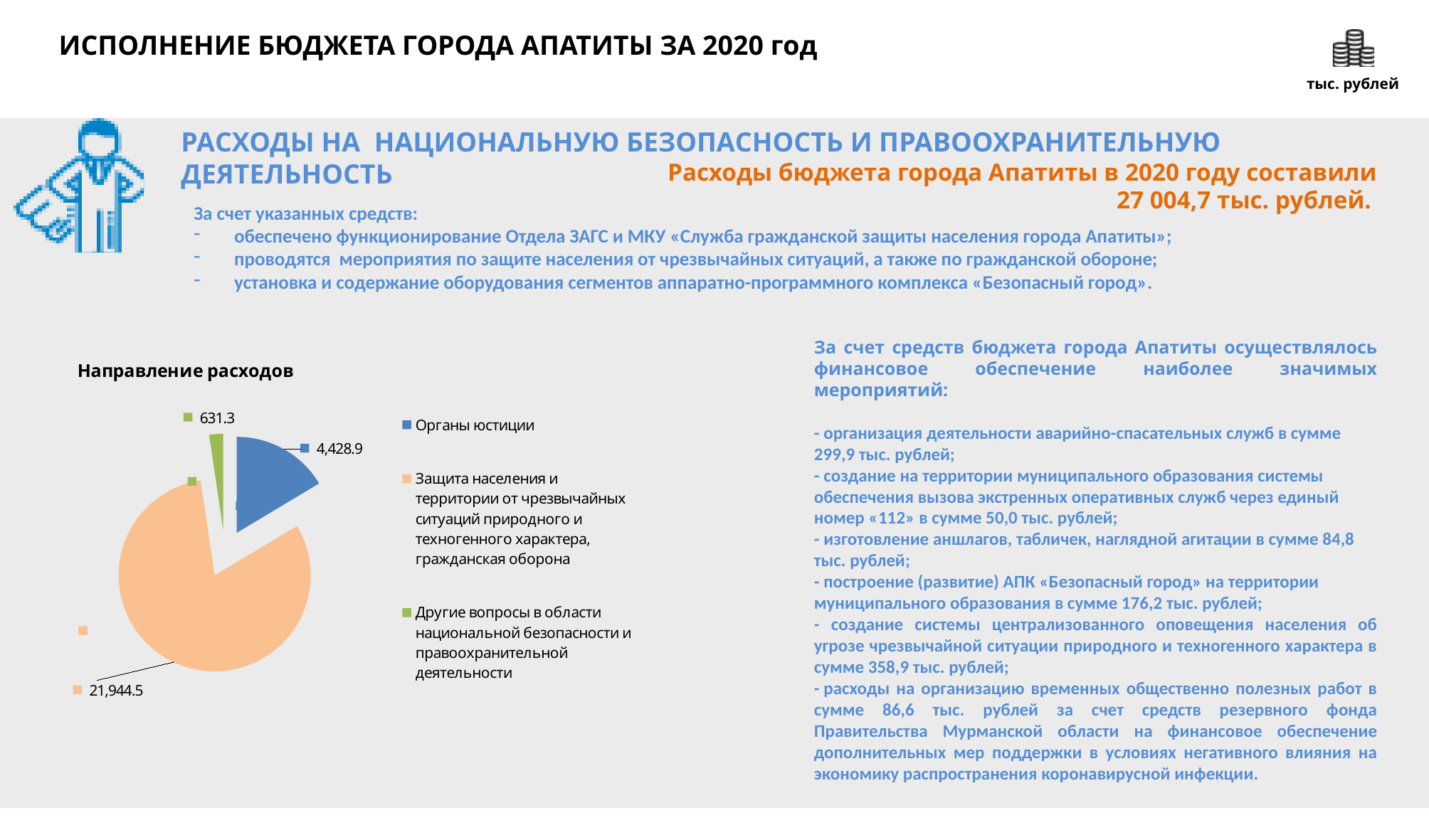
What is the title of the pie chart? Направление расходов What is the value for "Защита населения и территории от чрезвычайных ситуаций природного и техногенного характера, гражданская оборона" in the pie chart? 21,944.5 What is the difference between the values for "Органы юстиции" and "Другие вопросы в области национальной безопасности и правоохранительной деятельности" in the pie chart? 3,797.6 Which category has the smallest slice in the pie chart? Другие вопросы в области национальной безопасности и правоохранительной деятельности Which is larger in the pie chart: "Органы юстиции" or "Другие вопросы в области национальной безопасности и правоохранительной деятельности"? Органы юстиции What is the value for "Органы юстиции" in the pie chart? 4,428.9 What is the difference between the values for "Защита населения и территории от чрезвычайных ситуаций природного и техногенного характера, гражданская оборона" and "Органы юстиции" in the pie chart? 17,515.6 How many categories does the pie chart show? 3 What colour is the slice for "Органы юстиции" in the pie chart? blue What is the value for "Другие вопросы в области национальной безопасности и правоохранительной деятельности" in the pie chart? 631.3 What kind of chart is shown under the heading "Направление расходов"? pie chart Which category has the largest slice in the pie chart? Защита населения и территории от чрезвычайных ситуаций природного и техногенного характера, гражданская оборона